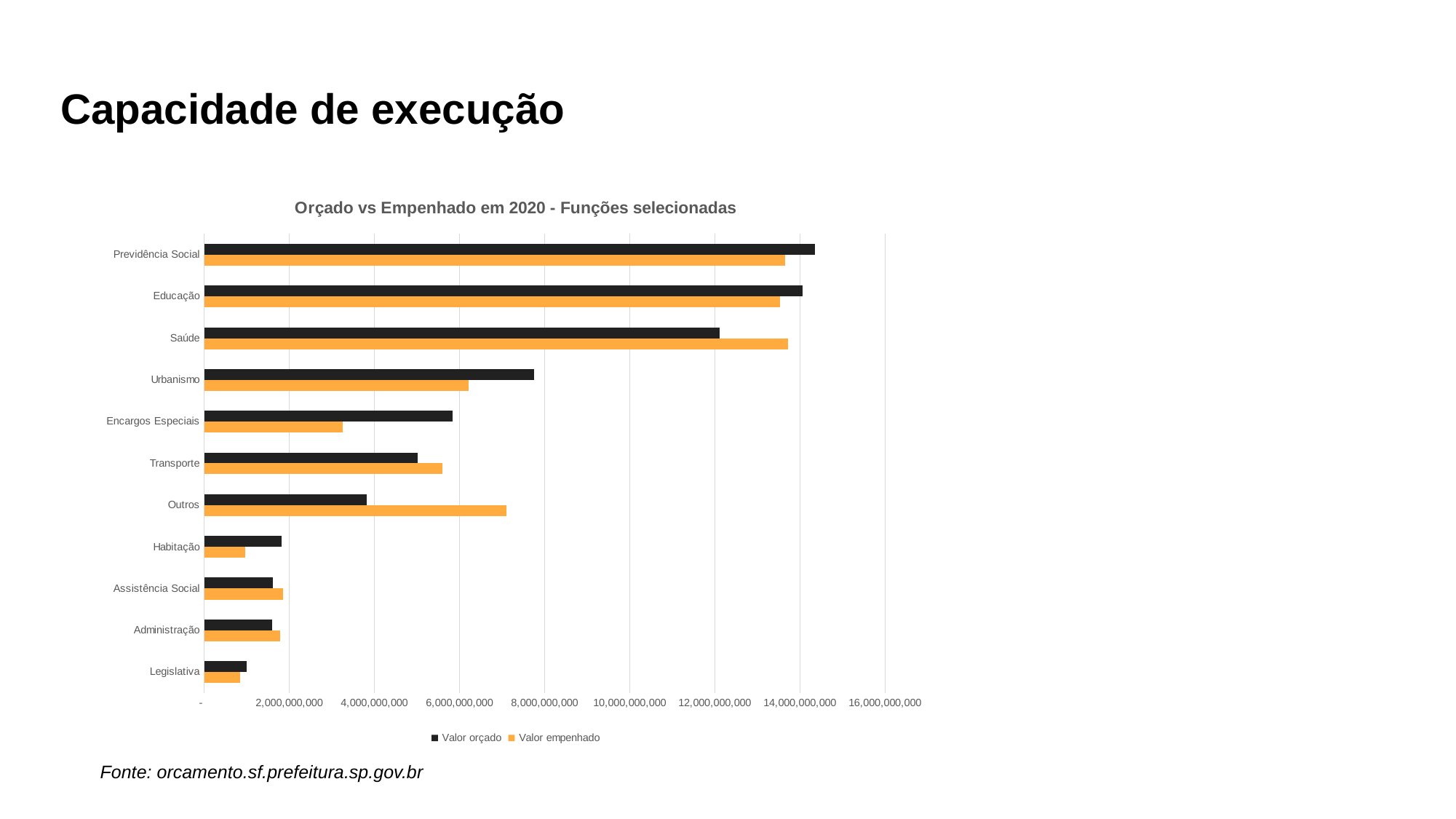
Is the Valor empenhado for Outros greater or less than 6,000,000,000? greater For Encargos Especiais, which is larger: Valor orçado or Valor empenhado? Valor orçado What kind of chart is shown on the slide? bar chart How many functions (categories) are plotted on the chart? 11 For Outros, which is larger: Valor orçado or Valor empenhado? Valor empenhado For Saúde, which is larger: Valor orçado or Valor empenhado? Valor empenhado What is the title of the chart? Orçado vs Empenhado em 2020 - Funções selecionadas Is the Valor orçado for Urbanismo greater or less than 8,000,000,000? less How many series does the legend list? 2 Which function has the lowest Valor orçado? Legislativa Is the Valor orçado for Saúde greater or less than 10,000,000,000? greater Which colour represents Valor empenhado in the chart? orange